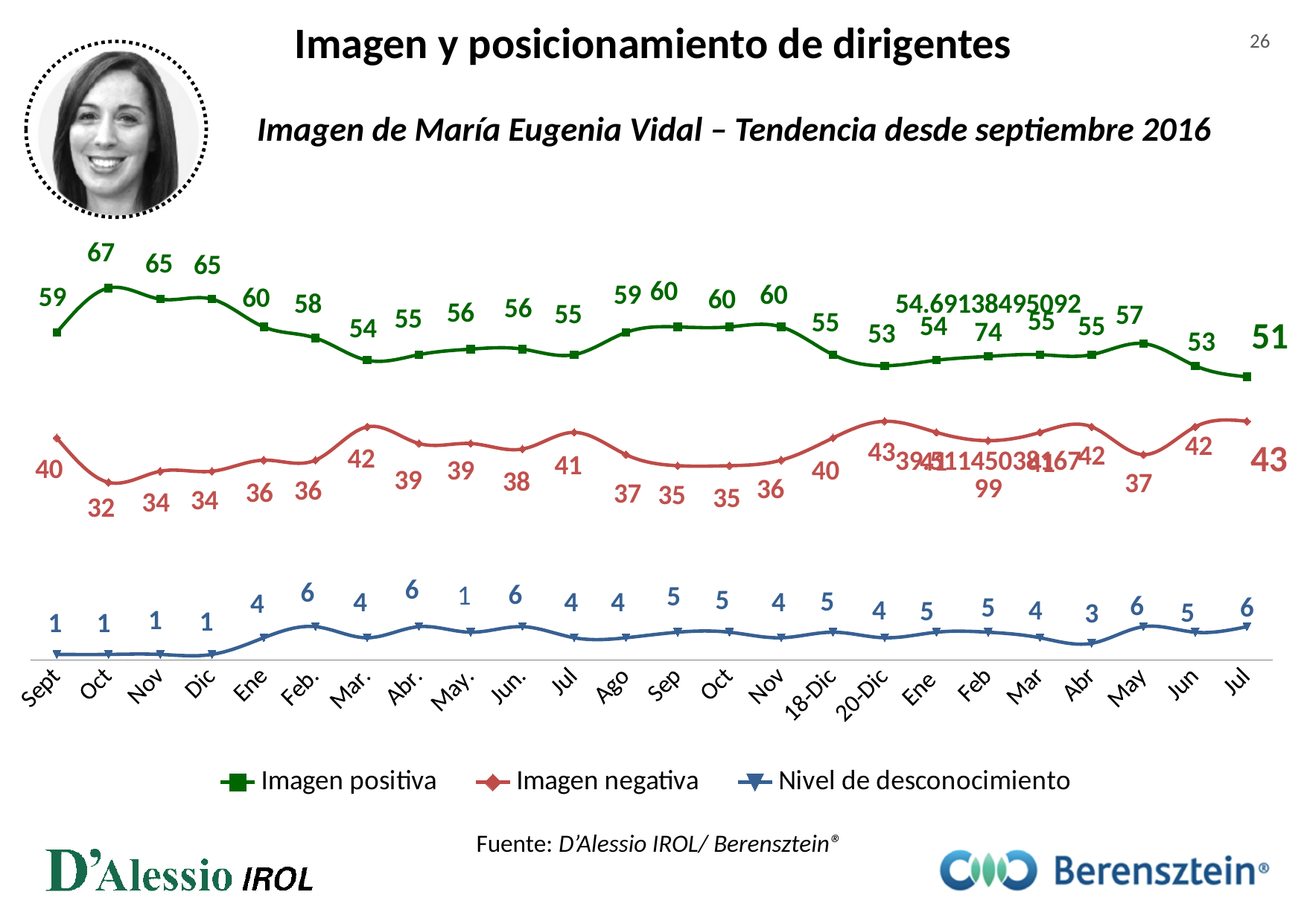
How many time points are plotted along the x axis? 24 What is the value of Imagen positiva at the last point, Jul? 51 How many series does the legend list? 3 What is the value of Imagen negativa at the first Mar. point? 42 What is the value of Nivel de desconocimiento at the first Feb. point? 6 What is the value of Imagen positiva at the first point, Sept? 59 What kind of chart is shown on the slide? line chart At the first point, Sept, what is the difference between Imagen positiva and Imagen negativa? 19 Which is larger for Imagen positiva: the first Oct value or the Dic value? Oct At which point does Imagen positiva reach its highest value, and what is it? Oct (the first Oct), 67 Does Imagen positiva rise or fall from the first Oct point to the first Mar. point? fall What is the lowest value of Imagen negativa, and at which point? 32, at the first Oct